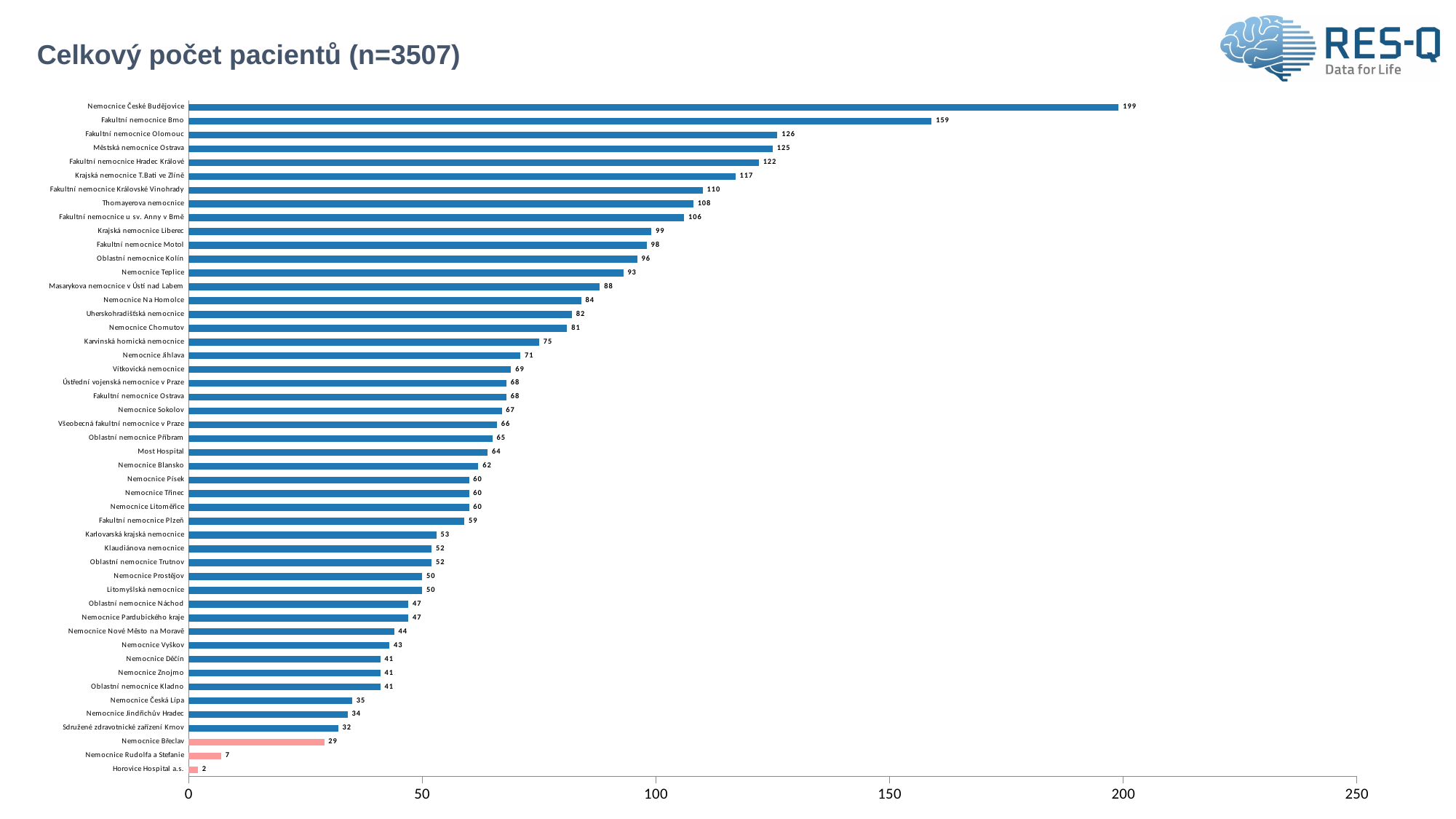
Which hospital has the lowest number of patients? Horovice Hospital a.s. What type of chart is shown on the slide? bar chart What is the value for Thomayerova nemocnice? 108 How many hospitals are shown in the chart? 49 How many bars are coloured pink/red instead of blue? 3 What is the difference between the values for Nemocnice České Budějovice and Fakultní nemocnice Brno? 40 Which has a larger value, Fakultní nemocnice Motol or Krajská nemocnice Liberec? Krajská nemocnice Liberec Is the value for Fakultní nemocnice Olomouc greater or less than 100? greater What is the value for Nemocnice Břeclav? 29 Which hospital has the highest number of patients? Nemocnice České Budějovice What is the title of the chart? Celkový počet pacientů (n=3507) What is the value for Fakultní nemocnice Brno? 159